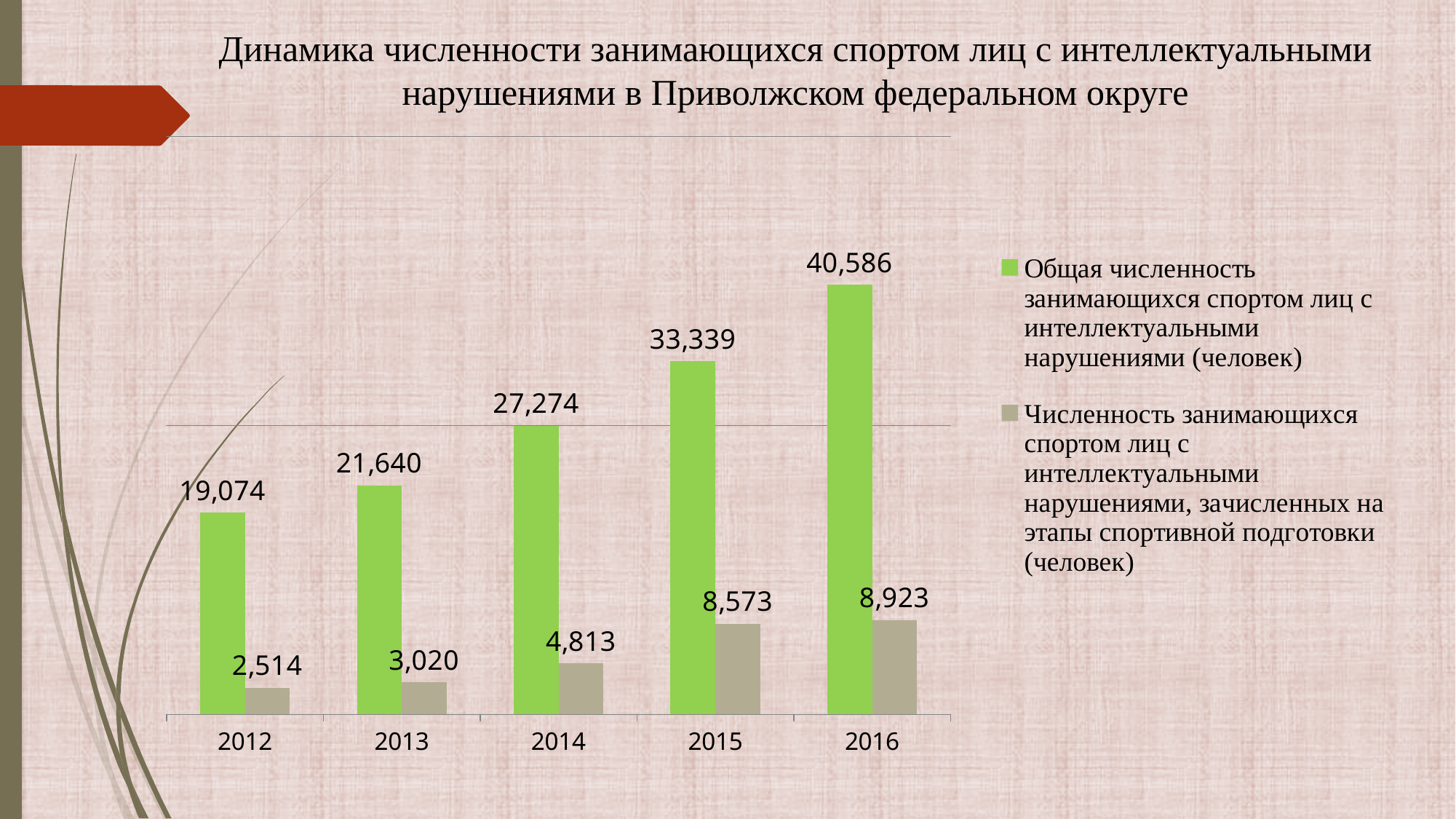
How many series does the legend list? 2 What is the total number of persons with intellectual disabilities engaged in sport (green series) in 2016? 40,586 How many years are shown on the x axis of the chart? 5 By how much did the total number engaged in sport (green series) increase from 2012 to 2016? 21,512 What kind of chart is shown on the slide? Bar chart In which year is the number enrolled in sports training stages (grey series) the lowest? 2012 In which year is the total number of persons engaged in sport (green series) the highest? 2016 Do the values of the green series rise or fall from 2012 to 2016? Rise Which is larger: the grey series value in 2015 or in 2016? 2016 What is the difference between the green and grey series values in 2016? 31,663 What is the value of the green series (total number engaged in sport) in 2012? 19,074 What is the number of persons enrolled in sports training stages (grey series) in 2014? 4,813